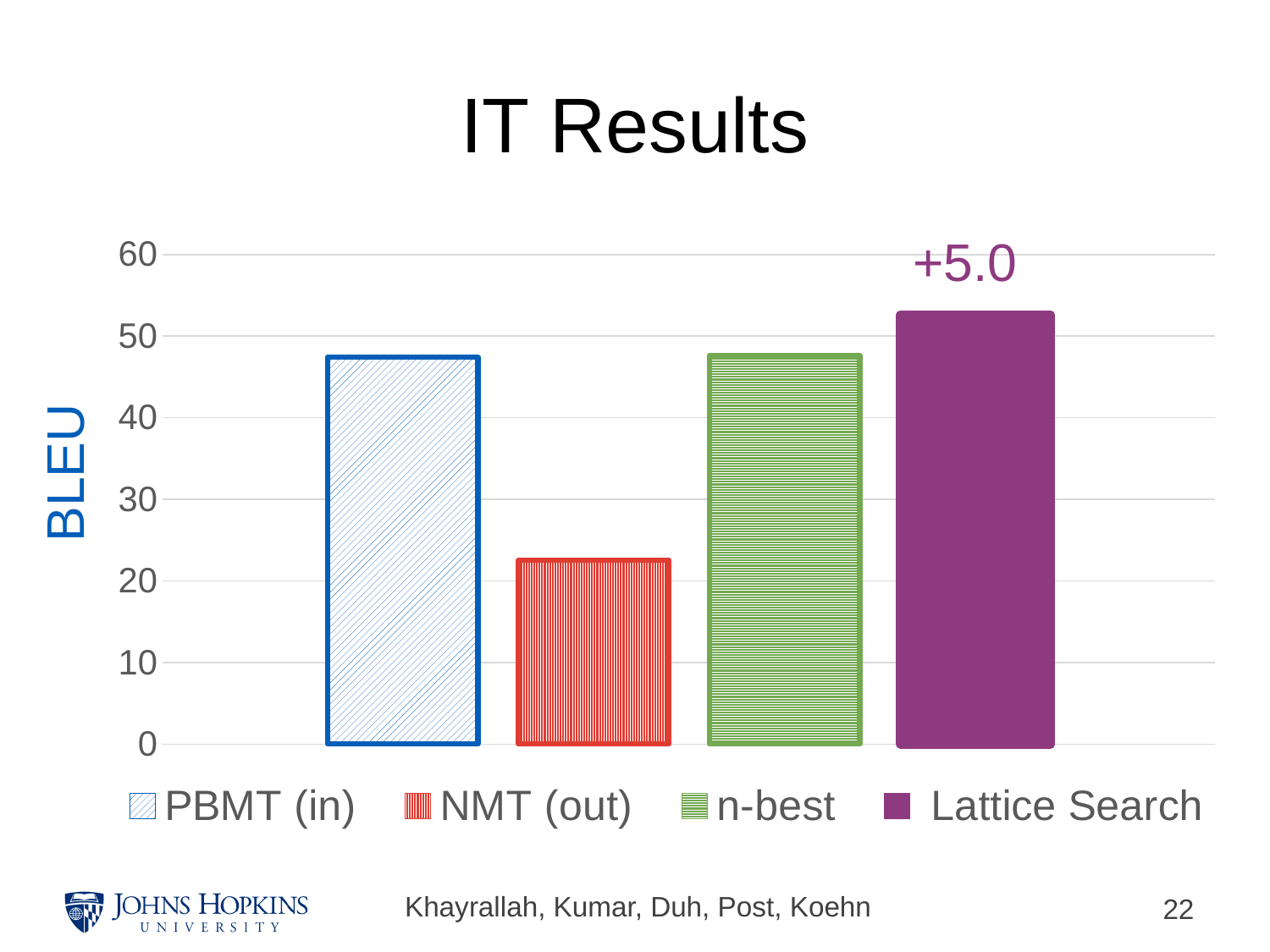
Which series has the highest BLEU score? Lattice Search Which is larger, the value for NMT (out) or the value for Lattice Search? Lattice Search Is the value for PBMT (in) greater or less than 40? greater Is the value for n-best greater or less than 50? less What is the title of the chart? IT Results Which series has the lowest BLEU score? NMT (out) Is the value for NMT (out) greater or less than 30? less How many series does the legend list? 4 What is the label on the y axis? BLEU What annotation is printed above the Lattice Search bar? +5.0 What kind of chart is shown on the slide? bar chart